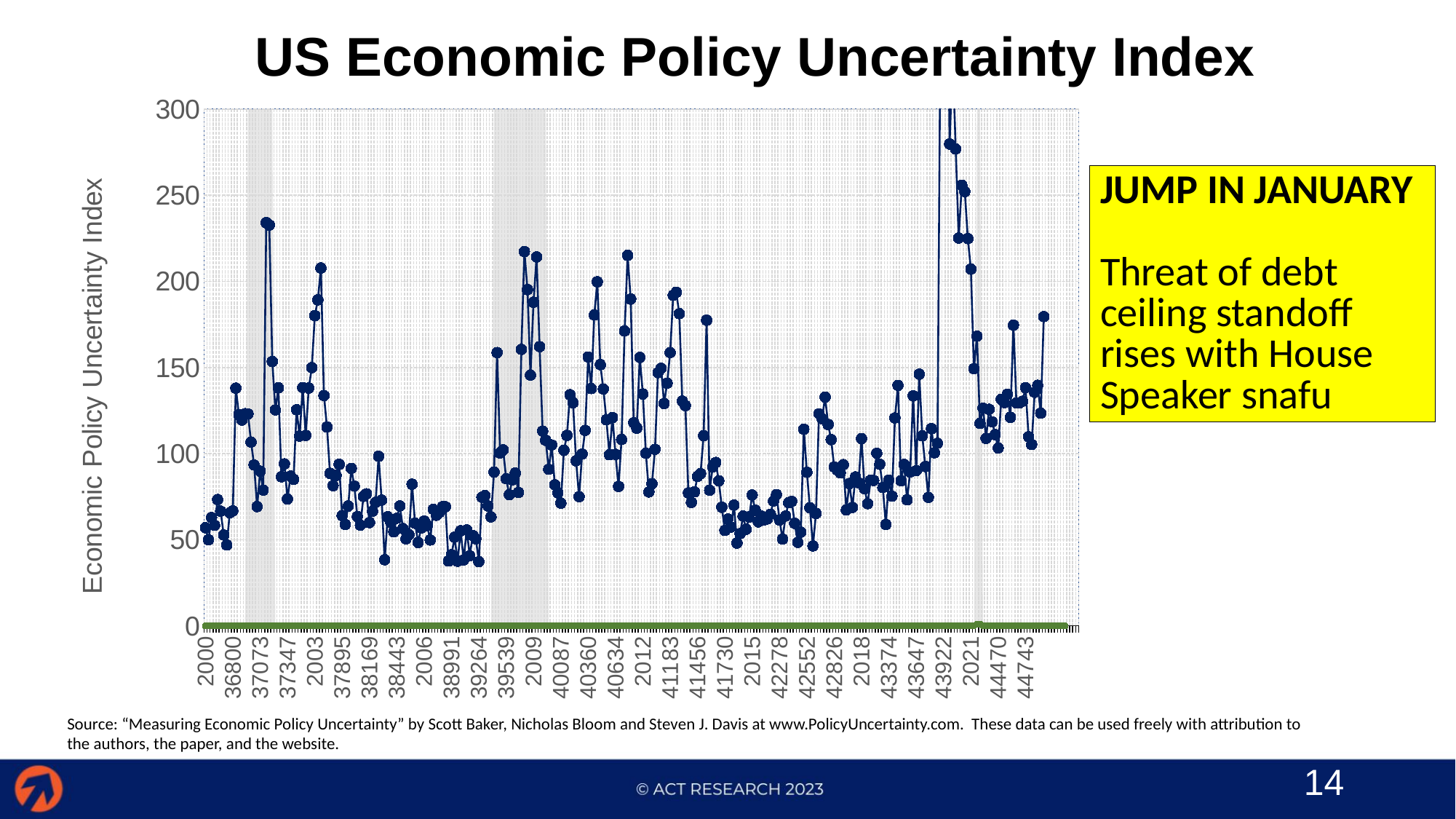
What kind of chart is shown on the slide? line chart What is the label on the vertical axis of the chart? Economic Policy Uncertainty Index Is the last point on the chart higher or lower than the first point? higher What is the title of the chart? US Economic Policy Uncertainty Index Is the lowest point on the chart greater or less than 50? less Is the last point on the chart greater or less than 150? greater Is the value at the first point (2000) greater or less than 100? less